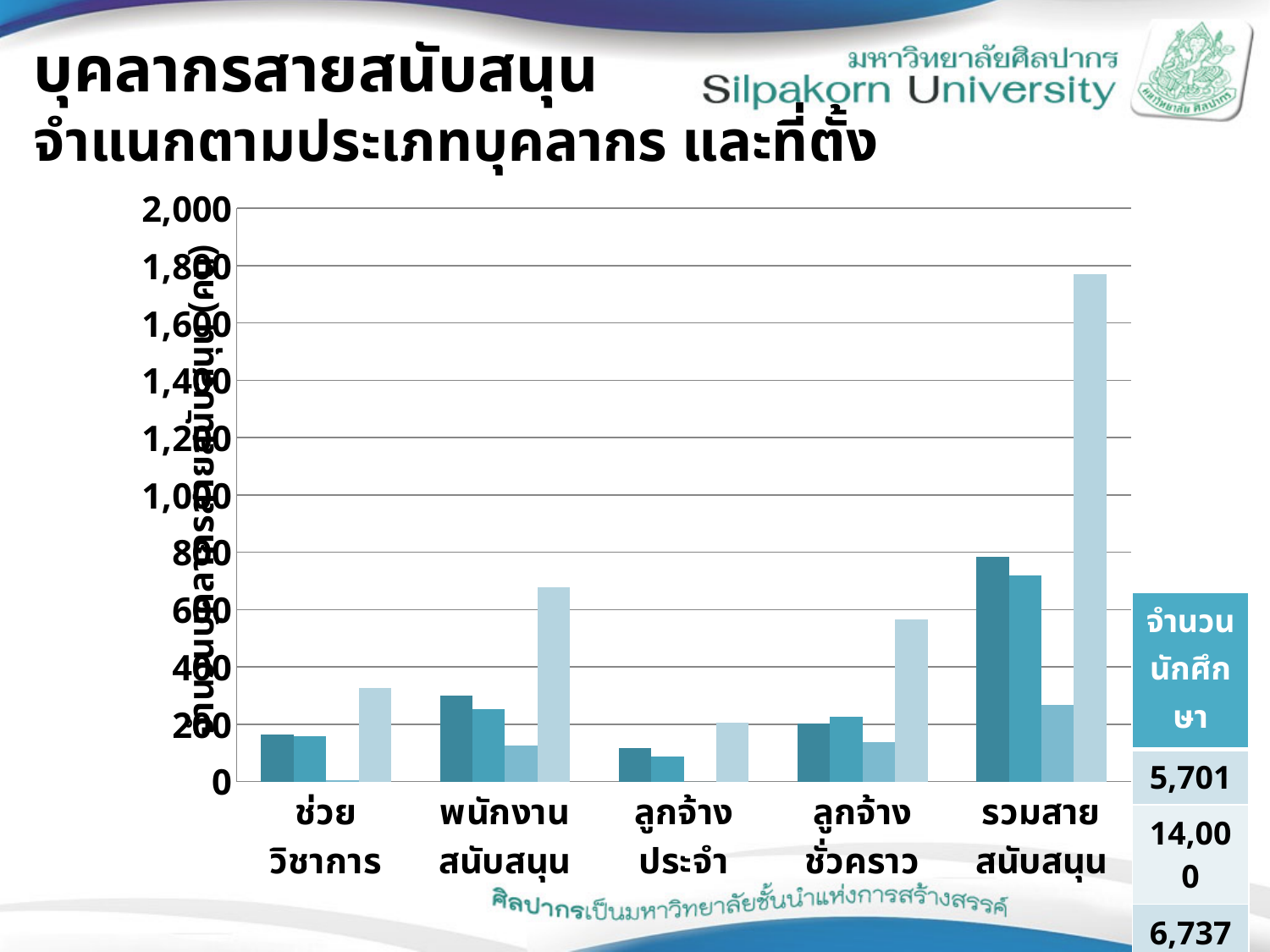
Is the value of the lightest-coloured bar for ลูกจ้างชั่วคราว greater or less than 400? greater What kind of chart is shown on the slide? bar chart For ช่วยวิชาการ, which bar is taller: the darkest bar or the lightest-coloured bar? the lightest-coloured bar How many categories are shown along the x axis of the chart? 5 Which category has the shortest bars overall in the chart? ลูกจ้างประจำ Is the value of the darkest bar for ช่วยวิชาการ greater or less than 200? less Which category has the tallest bar in the chart? รวมสายสนับสนุน Is the value of the lightest-coloured bar for รวมสายสนับสนุน greater or less than 1,600? greater What is the title of the slide containing the chart? บุคลากรสายสนับสนุน จำแนกตามประเภทบุคลากร และที่ตั้ง How many bars are plotted for each category in the chart? 4